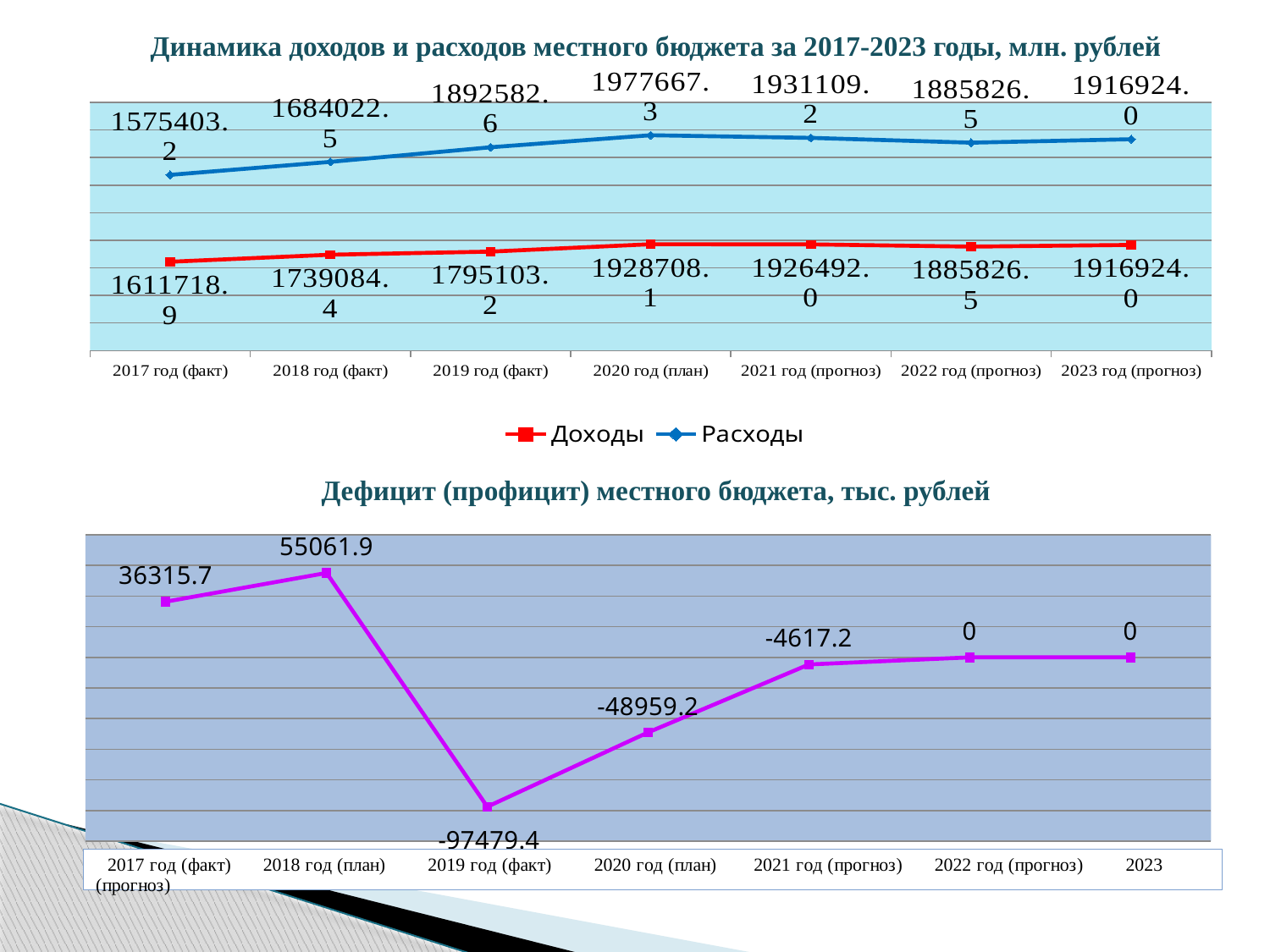
In the top chart (Динамика доходов и расходов), in which year is Расходы highest? 2020 год (план) In the bottom chart (Дефицит (профицит) местного бюджета), which year has the lowest value? 2019 год (факт) In the top chart (Динамика доходов и расходов), is Доходы larger for 2018 год (факт) or 2019 год (факт)? 2019 год (факт) In the bottom chart (Дефицит (профицит) местного бюджета), what is the difference between the values for 2018 год (план) and 2017 год (факт)? 18746.2 In the top chart (Динамика доходов и расходов), what is the value of Расходы for 2020 год (план)? 1977667.3 In the top chart (Динамика доходов и расходов), what is the difference between Расходы and Доходы for 2019 год (факт)? 97479.4 How many series does the legend of the top chart (Динамика доходов и расходов) list? 2 In the top chart (Динамика доходов и расходов), what is the value of Доходы for 2017 год (факт)? 1611718.9 What type of chart is the bottom chart titled 'Дефицит (профицит) местного бюджета, тыс. рублей'? line chart How many categories are shown on the x axis of the top chart (Динамика доходов и расходов)? 7 In the bottom chart (Дефицит (профицит) местного бюджета), what is the value for 2021 год (прогноз)? -4617.2 What type of chart is the top chart titled 'Динамика доходов и расходов местного бюджета за 2017-2023 годы, млн. рублей'? line chart